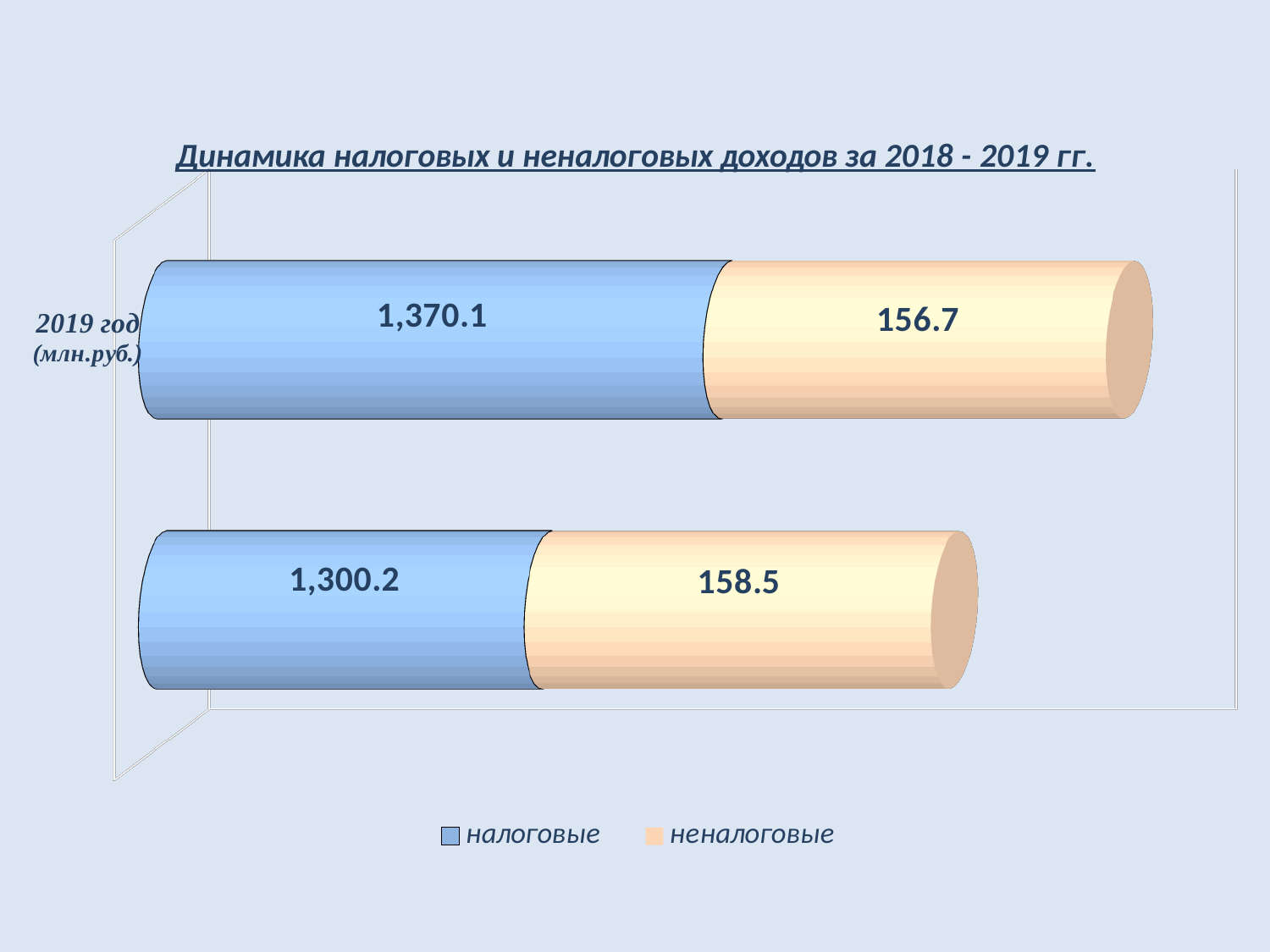
What kind of chart is shown on the slide? Stacked bar chart What is the value of налоговые for 2019 год? 1,370.1 What is the value of налоговые in the lower bar? 1,300.2 What is the total of the stacked bar for 2019 год? 1,526.8 What is the difference between налоговые for 2019 год and налоговые in the lower bar? 69.9 What is the value of неналоговые in the lower bar? 158.5 What is the difference between неналоговые in the lower bar and неналоговые for 2019 год? 1.8 What is the value of неналоговые for 2019 год? 156.7 What is the total of the lower stacked bar? 1,458.7 What is the title of the chart? Динамика налоговых и неналоговых доходов за 2018 - 2019 гг. Which is larger for 2019 год: налоговые or неналоговые? налоговые How many series does the legend list? 2